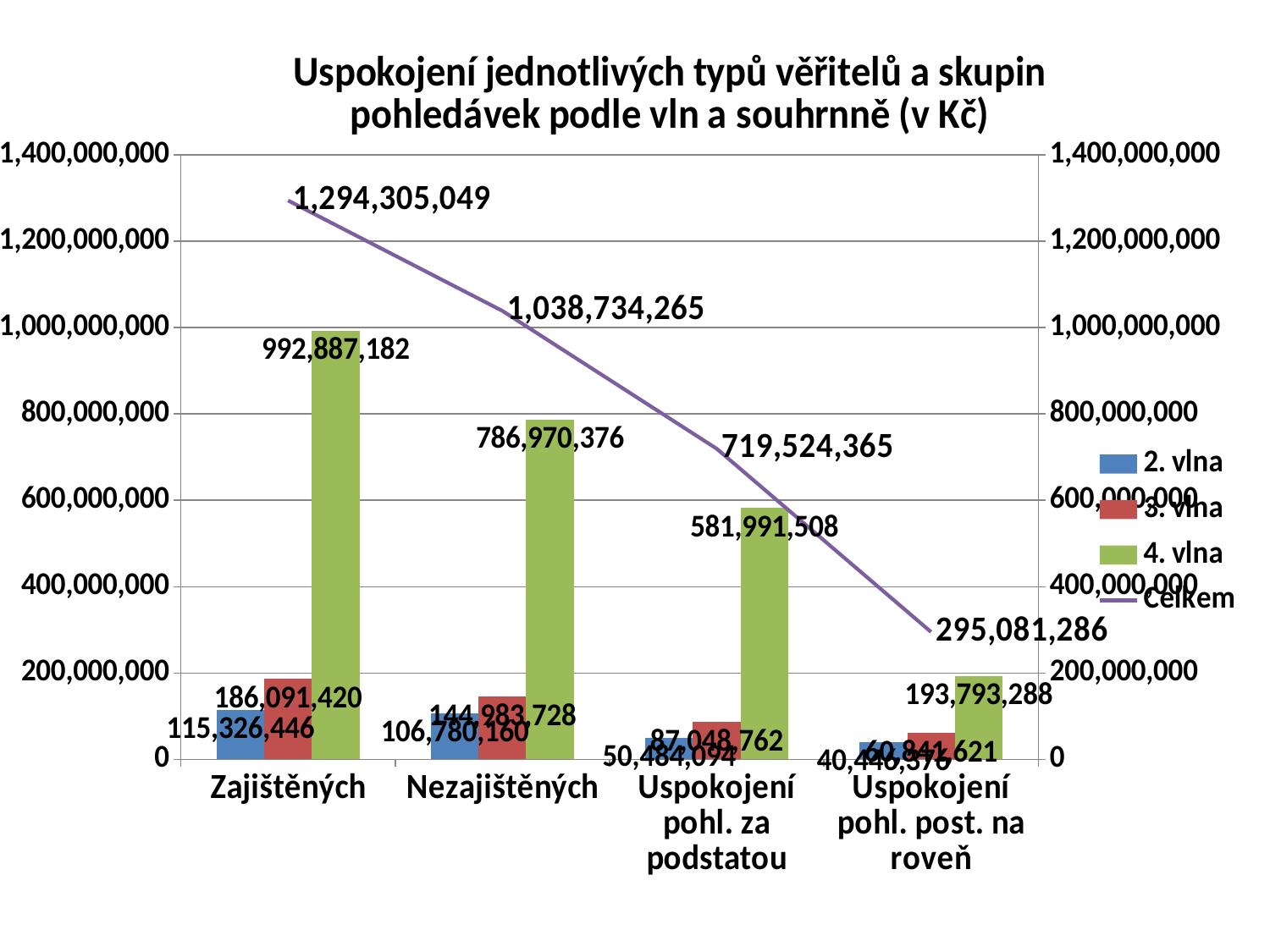
Is the 4. vlna value for Uspokojení pohl. za podstatou greater or less than 600,000,000? less What is the difference between the Celkem values for Zajištěných and Nezajištěných? 255,570,784 How many series does the legend list? 4 What is the Celkem value for Nezajištěných? 1,038,734,265 How many categories are shown on the x axis? 4 What is the value of the 4. vlna series for Uspokojení pohl. post. na roveň? 193,793,288 What is the value of the 4. vlna series for Zajištěných? 992,887,182 Which category has the lowest Celkem value? Uspokojení pohl. post. na roveň What is the value of the 3. vlna series for Zajištěných? 186,091,420 Does the Celkem line rise or fall from left to right across the categories? falls Which category has the highest Celkem value? Zajištěných Which is larger: the 4. vlna value for Nezajištěných or the 4. vlna value for Uspokojení pohl. za podstatou? Nezajištěných